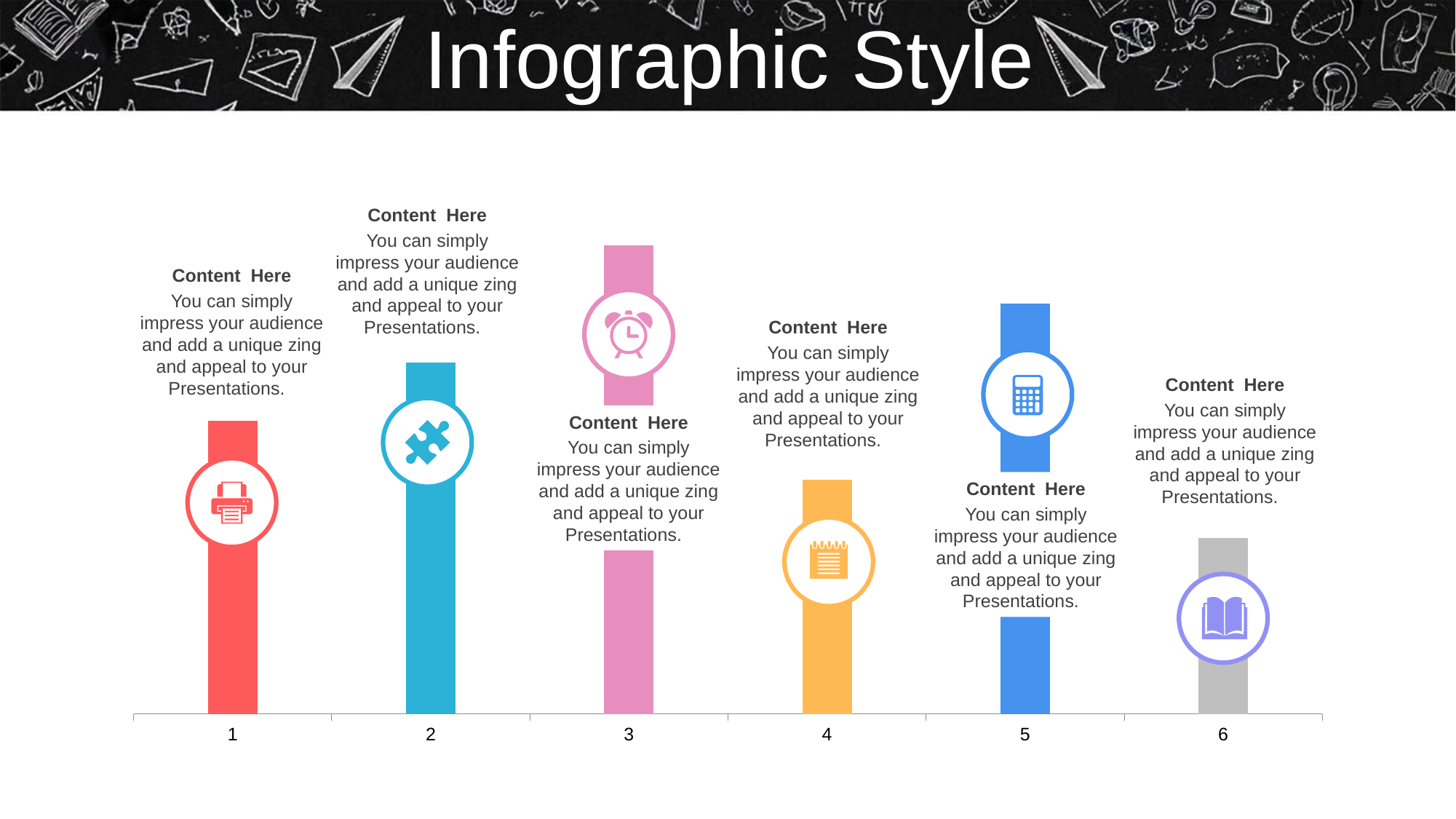
What colour is the bar for category 1? red Which bar is taller, category 4 or category 6? 4 Which bar is taller, category 2 or category 4? 2 Which bar is taller, category 5 or category 1? 5 Which category has the shortest bar? 6 What kind of chart is shown on the slide? bar chart How many bars (categories) does the chart show? 6 What is the title shown at the top of the slide? Infographic Style Which category has the tallest bar? 3